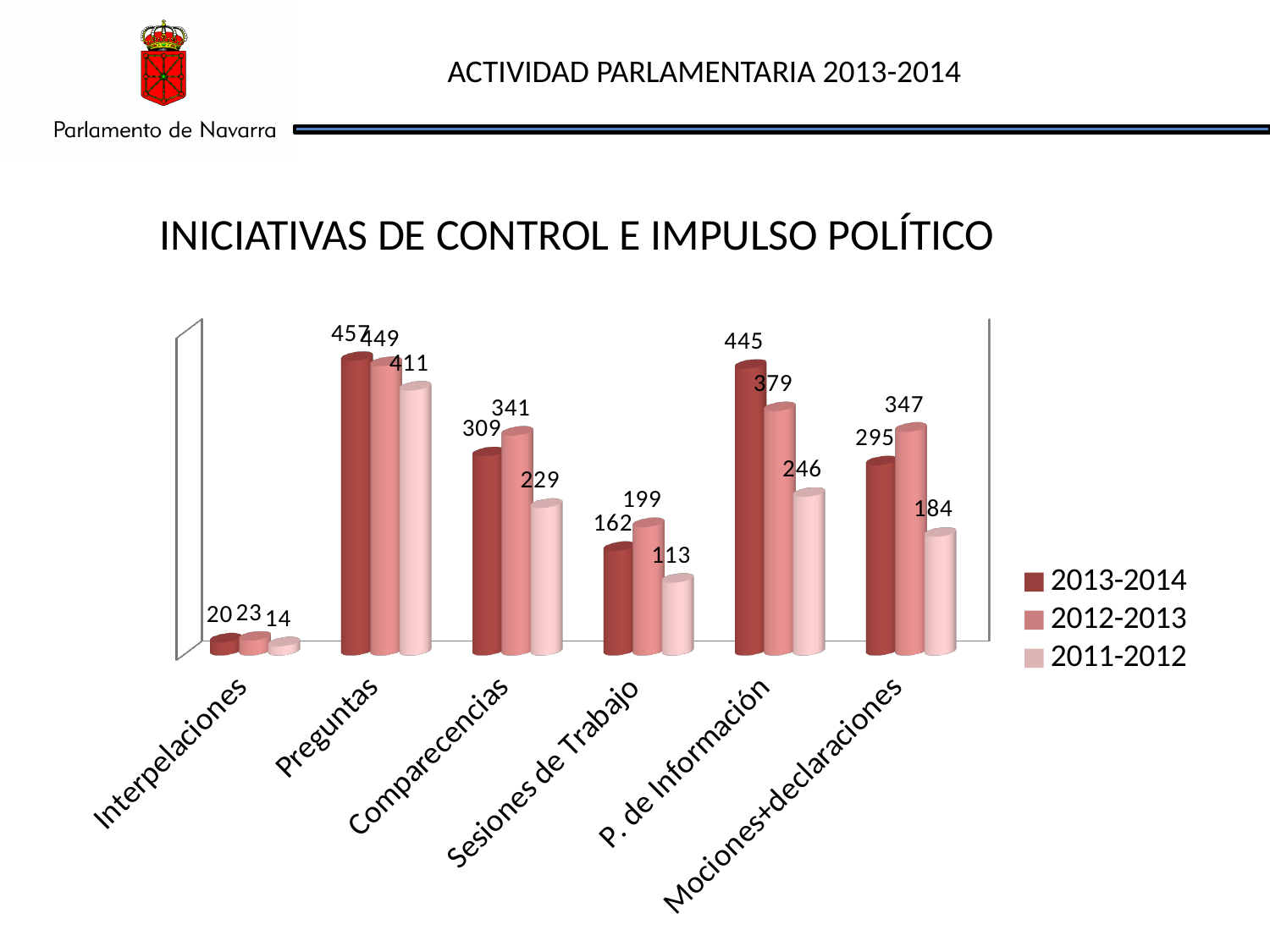
What kind of chart is shown on the slide? Bar chart Which category has the lowest value in the 2013-2014 series? Interpelaciones What is the value for Preguntas in the 2013-2014 series? 457 What is the difference between the 2013-2014 and 2011-2012 values for P. de Información? 199 How many categories are shown on the x axis? 6 What is the value for P. de Información in the 2011-2012 series? 246 What is the value for Mociones+declaraciones in the 2012-2013 series? 347 What is the title of the chart? INICIATIVAS DE CONTROL E IMPULSO POLÍTICO Which is larger for Comparecencias: the 2013-2014 value or the 2012-2013 value? 2012-2013 Which category has the highest value in the 2011-2012 series? Preguntas What is the value for Sesiones de Trabajo in the 2011-2012 series? 113 How many series does the legend list? 3